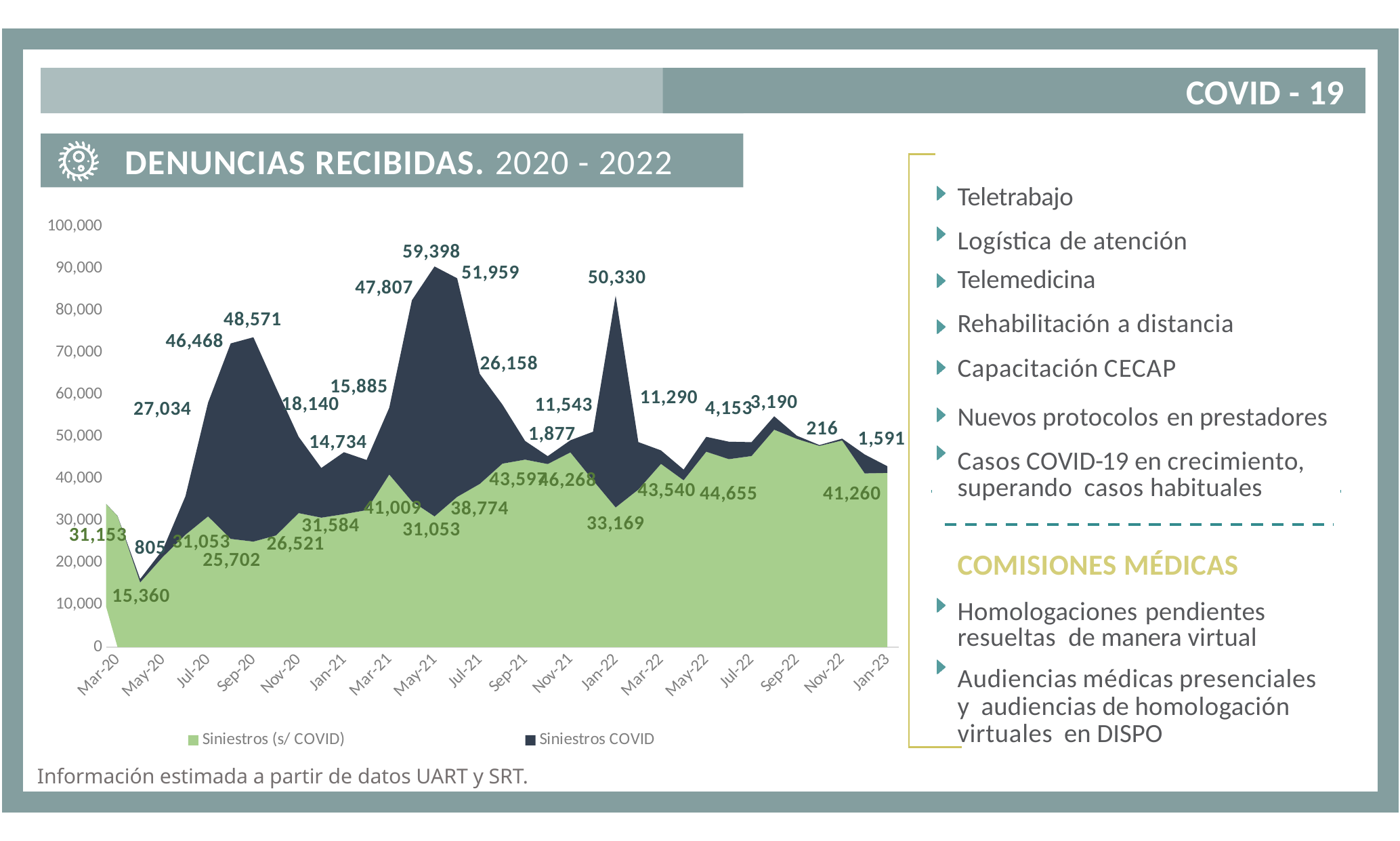
What is the Siniestros COVID value at Jan-22? 50,330 How many series does the legend list? 2 What is the difference between the two largest labelled Siniestros COVID values, 59,398 and 50,330? 9,068 What is the lowest labelled value for the Siniestros COVID series? 216 What is the title of the chart? DENUNCIAS RECIBIDAS. 2020 - 2022 Is the combined total of both series at Jan-22 greater or less than 80,000? greater What are the two series named in the legend? Siniestros (s/ COVID) and Siniestros COVID What is the highest labelled value for the Siniestros COVID series? 59,398 What is the highest labelled value for the Siniestros (s/ COVID) series? 46,268 What kind of chart is shown on the slide? Stacked area chart What is the lowest labelled value for the Siniestros (s/ COVID) series? 15,360 What is the Siniestros COVID value at Jan-23? 1,591